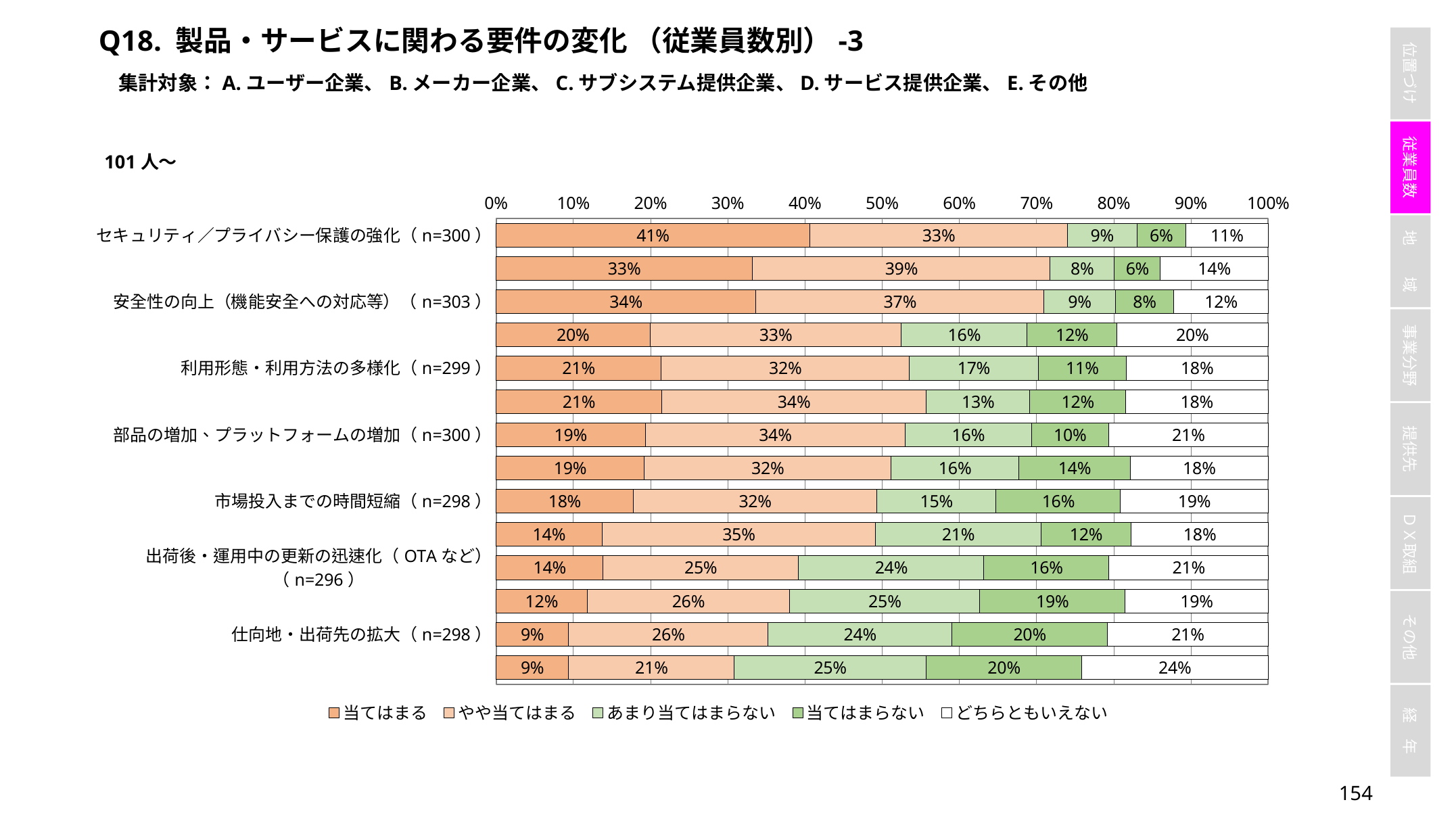
What kind of chart is shown on the slide? Stacked bar chart Among the labeled categories, which has the highest 当てはまる value? セキュリティ／プライバシー保護の強化 Among the labeled categories, which has the lowest 当てはまる value? 仕向地・出荷先の拡大 Which has a larger 当てはまらない value: 市場投入までの時間短縮 or 利用形態・利用方法の多様化? 市場投入までの時間短縮 What is the value of やや当てはまる for 安全性の向上（機能安全への対応等）(n=303)? 37% What is the value of どちらともいえない for 仕向地・出荷先の拡大 (n=298)? 21% What is the value of 当てはまらない for 部品の増加、プラットフォームの増加 (n=300)? 10% What is the value of 当てはまる for セキュリティ／プライバシー保護の強化 (n=300)? 41% What is the difference in 当てはまる between セキュリティ／プライバシー保護の強化 and 安全性の向上（機能安全への対応等）? 7 percentage points What is the first entry in the chart legend? 当てはまる What is the value of あまり当てはまらない for 出荷後・運用中の更新の迅速化（OTA など）(n=296)? 24% How many series does the legend list? 5